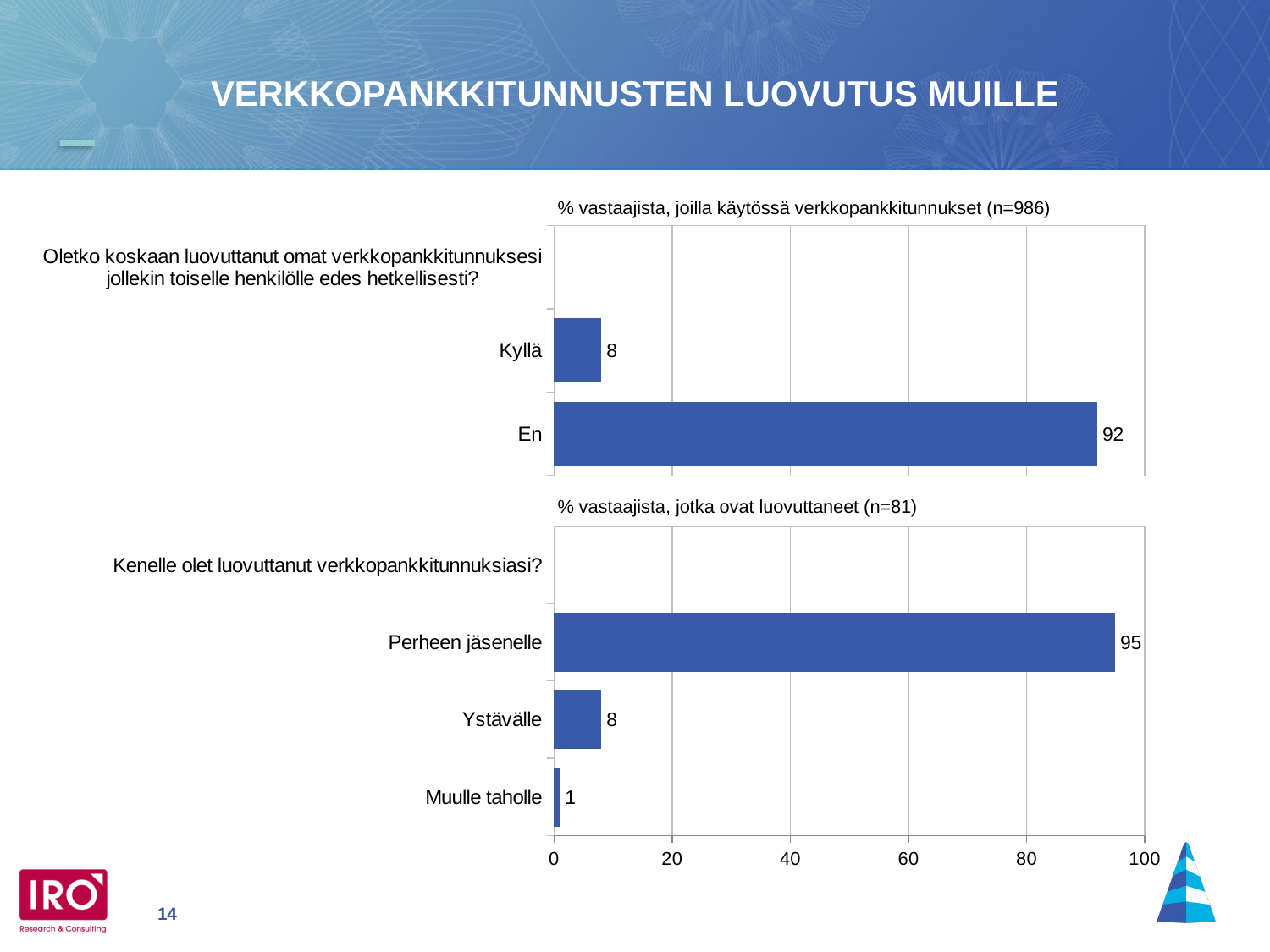
In the bottom chart (% vastaajista, jotka ovat luovuttaneet), what is the value for Perheen jäsenelle? 95 How many categories are plotted in the bottom chart (Kenelle olet luovuttanut verkkopankkitunnuksiasi?)? 3 In the bottom chart (% vastaajista, jotka ovat luovuttaneet), what is the value for Ystävälle? 8 In the bottom chart, which category has the lowest value? Muulle taholle In the bottom chart, what is the difference between the values for Perheen jäsenelle and Ystävälle? 87 In the top chart, what is the difference between the values for En and Kyllä? 84 What type of chart is the top chart on the slide? Bar chart In the top chart (% vastaajista, joilla käytössä verkkopankkitunnukset), what is the value for Kyllä? 8 In the bottom chart (% vastaajista, jotka ovat luovuttaneet), what is the value for Muulle taholle? 1 In the top chart (% vastaajista, joilla käytössä verkkopankkitunnukset), what is the value for En? 92 In the bottom chart, which category has the highest value? Perheen jäsenelle In the top chart, which category has the higher value, Kyllä or En? En